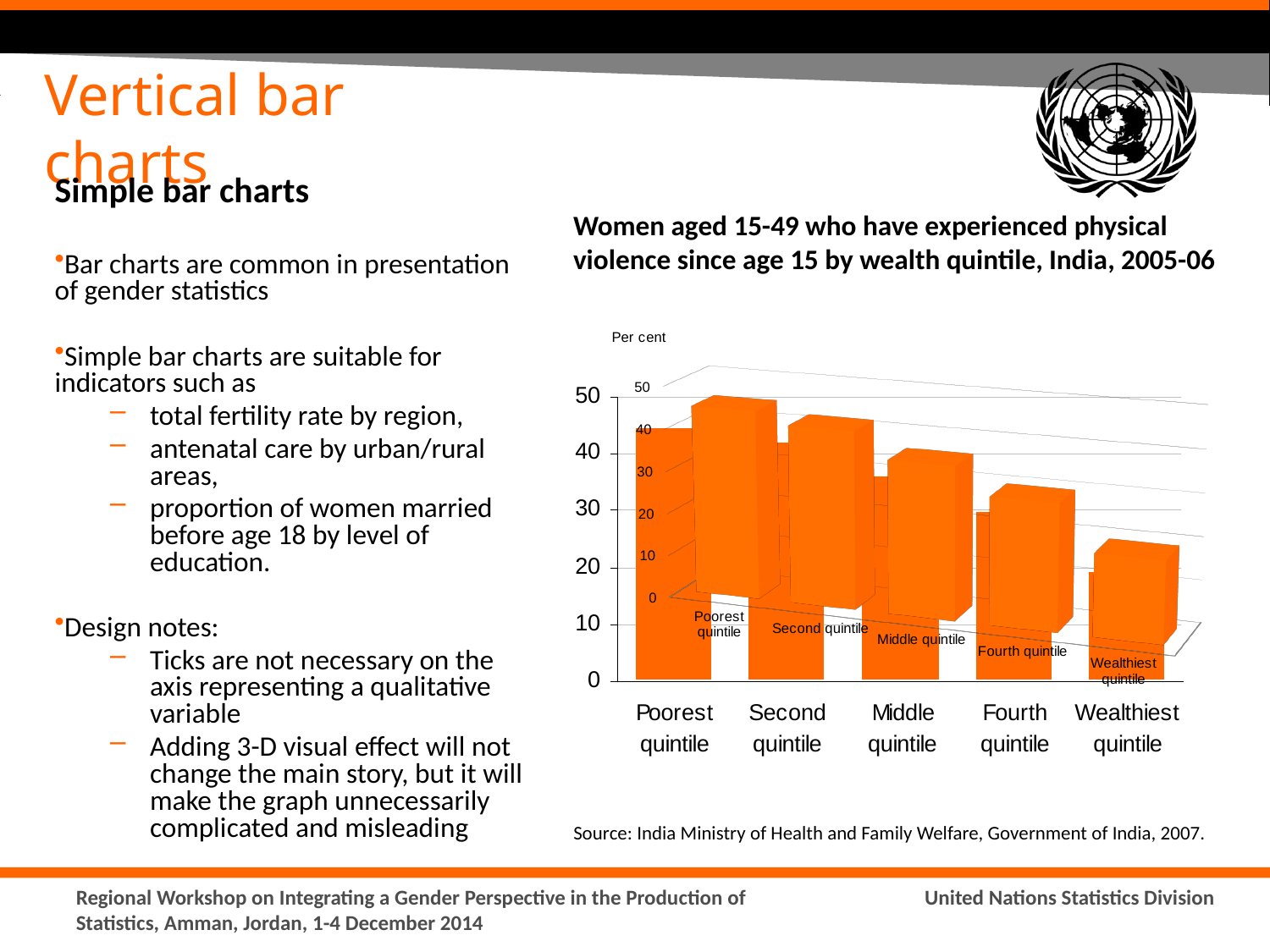
What kind of chart is used to show women who have experienced physical violence by wealth quintile? Bar chart Do the values in the bar chart rise or fall as you move from the Poorest quintile to the Wealthiest quintile? Fall Which wealth quintile has the lowest value in the bar chart? Wealthiest quintile Which wealth quintile has the highest value in the bar chart? Poorest quintile What unit label is shown above the vertical axis of the chart? Per cent Which has the larger value in the bar chart, the Second quintile or the Fourth quintile? Second quintile How many wealth quintile categories are shown on the x axis of the bar chart? 5 In the 2-D bar chart, is the value for the Wealthiest quintile greater or less than 30? less In the 2-D bar chart, is the value for the Middle quintile greater or less than 30? greater What country and period does the chart title say the data refer to? India, 2005-06 Which has the larger value in the bar chart, the Poorest quintile or the Wealthiest quintile? Poorest quintile In the 2-D bar chart, is the value for the Poorest quintile greater or less than 40? greater